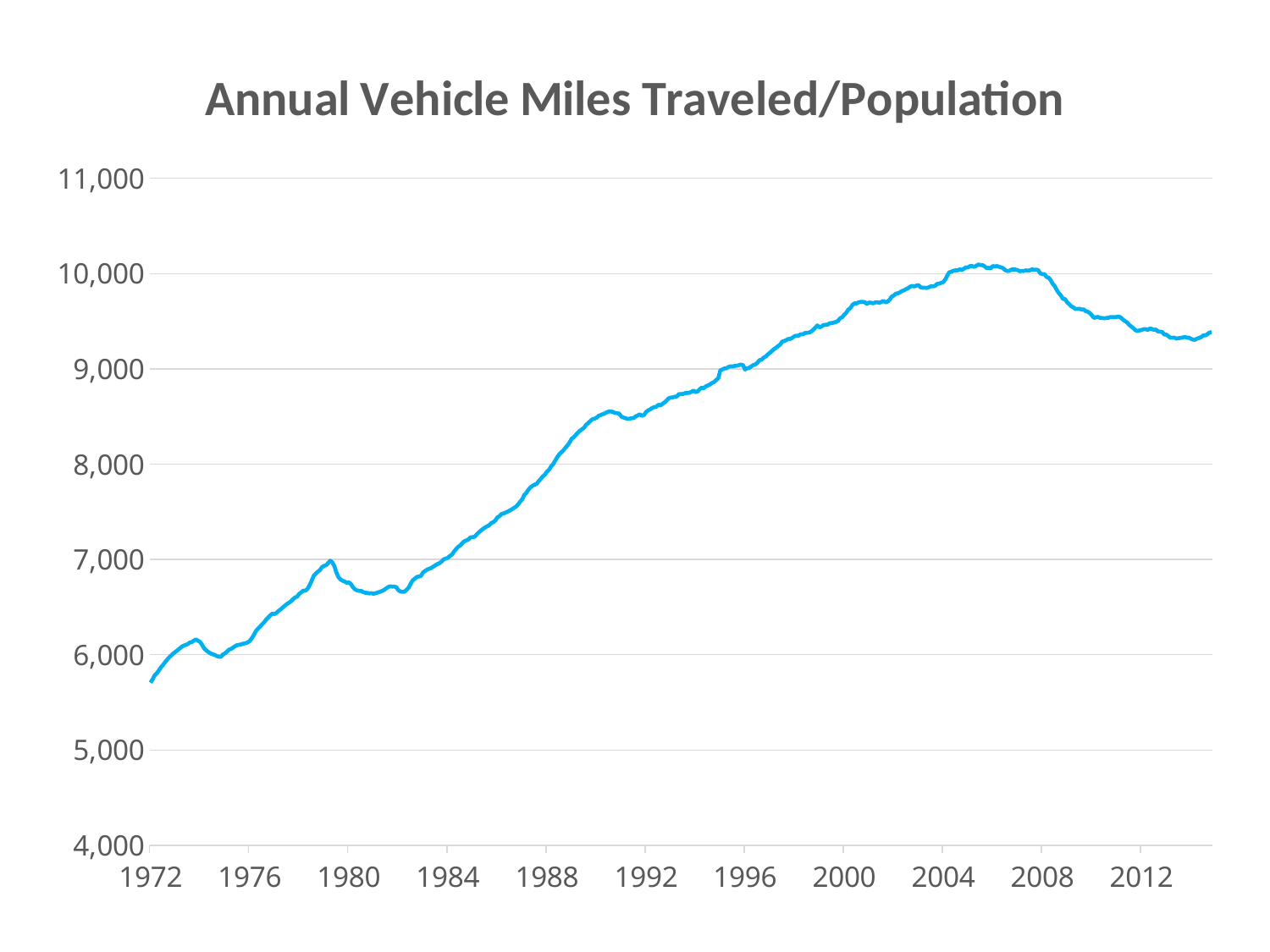
Is the value for 2012 greater or less than 10,000? less What kind of chart is shown on the slide? line chart Does the line rise or fall between 2008 and 2012? fall What is the title of the chart? Annual Vehicle Miles Traveled/Population Is the value for 1972 greater or less than 6,000? less Which year has the larger value, 1976 or 2000? 2000 Is the value for 1992 greater or less than 8,000? greater Does the line generally rise or fall between 1972 and 2004? rise How many lines (series) are plotted on the chart? 1 What is the highest value shown on the vertical axis? 11,000